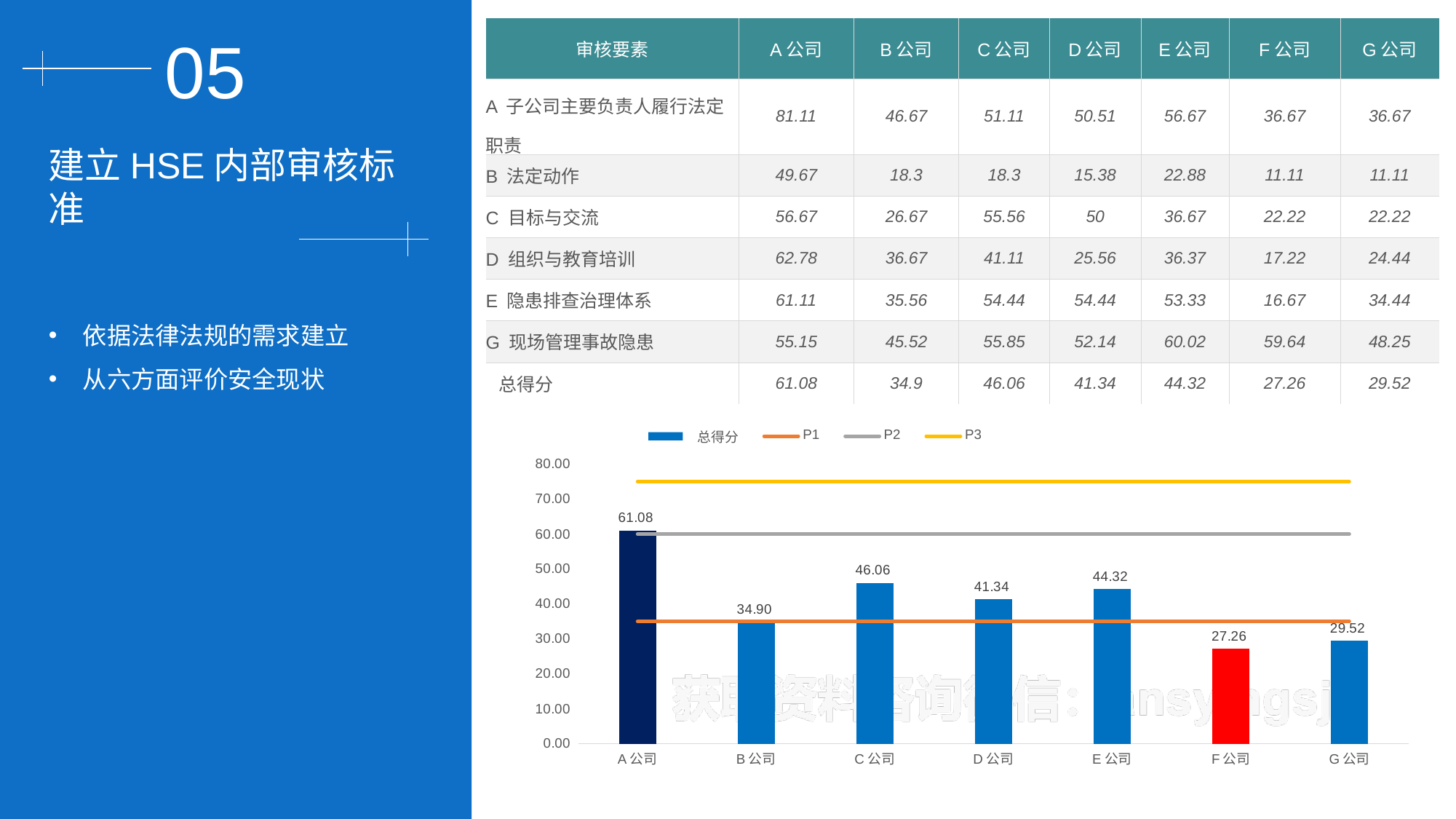
What is the 总得分 value for A 公司 in the bar chart? 61.08 What is the difference between the 总得分 values of A 公司 and B 公司 in the bar chart? 26.18 What is the 总得分 value for F 公司 in the bar chart? 27.26 How many companies are shown on the x axis of the bar chart? 7 How many series does the chart legend list? 4 Which has a larger 总得分 in the bar chart, C 公司 or D 公司? C 公司 What is the 总得分 value for E 公司 in the bar chart? 44.32 Is the P3 line in the chart greater or less than 70.00? greater Which company has the lowest 总得分 bar in the chart? F 公司 What type of chart is used to show 总得分 on the slide? Bar chart Which company has the highest 总得分 bar in the chart? A 公司 Is the P1 line in the chart greater or less than 40.00? less